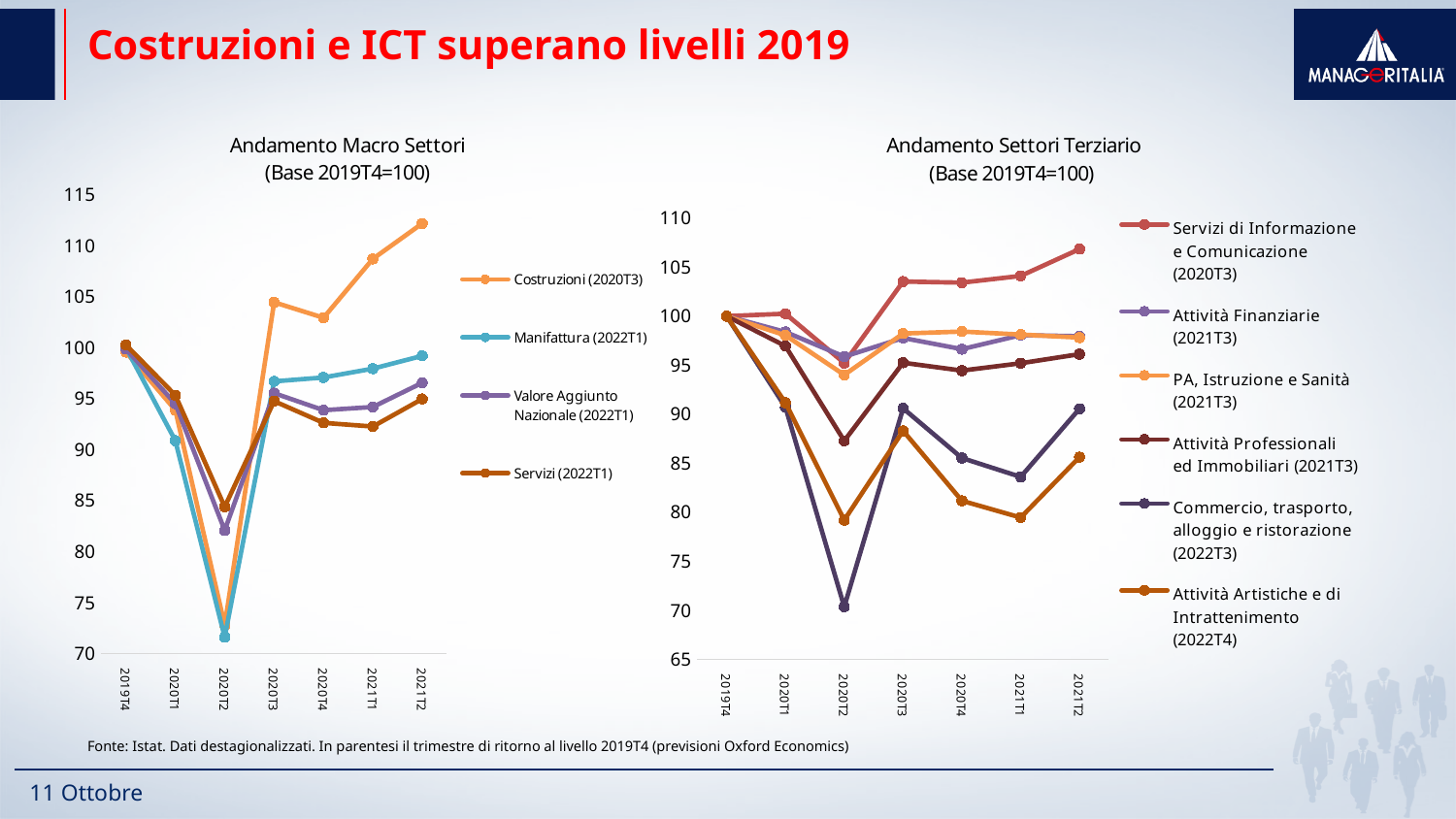
What kind of chart is the left chart, 'Andamento Macro Settori'? Line chart In the left chart 'Andamento Macro Settori', which is larger at 2021T2: Costruzioni or Servizi? Costruzioni In the left chart 'Andamento Macro Settori', which series has the highest value at 2021T2? Costruzioni (2020T3) In the left chart 'Andamento Macro Settori', how many series does the legend list? 4 In the right chart 'Andamento Settori Terziario', is the value for Servizi di Informazione e Comunicazione at 2021T2 greater or less than 105? greater In the right chart 'Andamento Settori Terziario', how many series does the legend list? 6 In the right chart 'Andamento Settori Terziario', does the Commercio, trasporto, alloggio e ristorazione series rise or fall from 2019T4 to 2020T2? fall In the left chart 'Andamento Macro Settori', how many quarters are shown on the x axis? 7 In the right chart 'Andamento Settori Terziario', which series has the lowest value at 2020T2? Commercio, trasporto, alloggio e ristorazione (2022T3) In the left chart 'Andamento Macro Settori', is the value for Manifattura at 2020T2 greater or less than 75? less In the right chart 'Andamento Settori Terziario', which series has the highest value at 2021T2? Servizi di Informazione e Comunicazione (2020T3) In the left chart 'Andamento Macro Settori', is the value for Costruzioni at 2021T2 greater or less than 110? greater